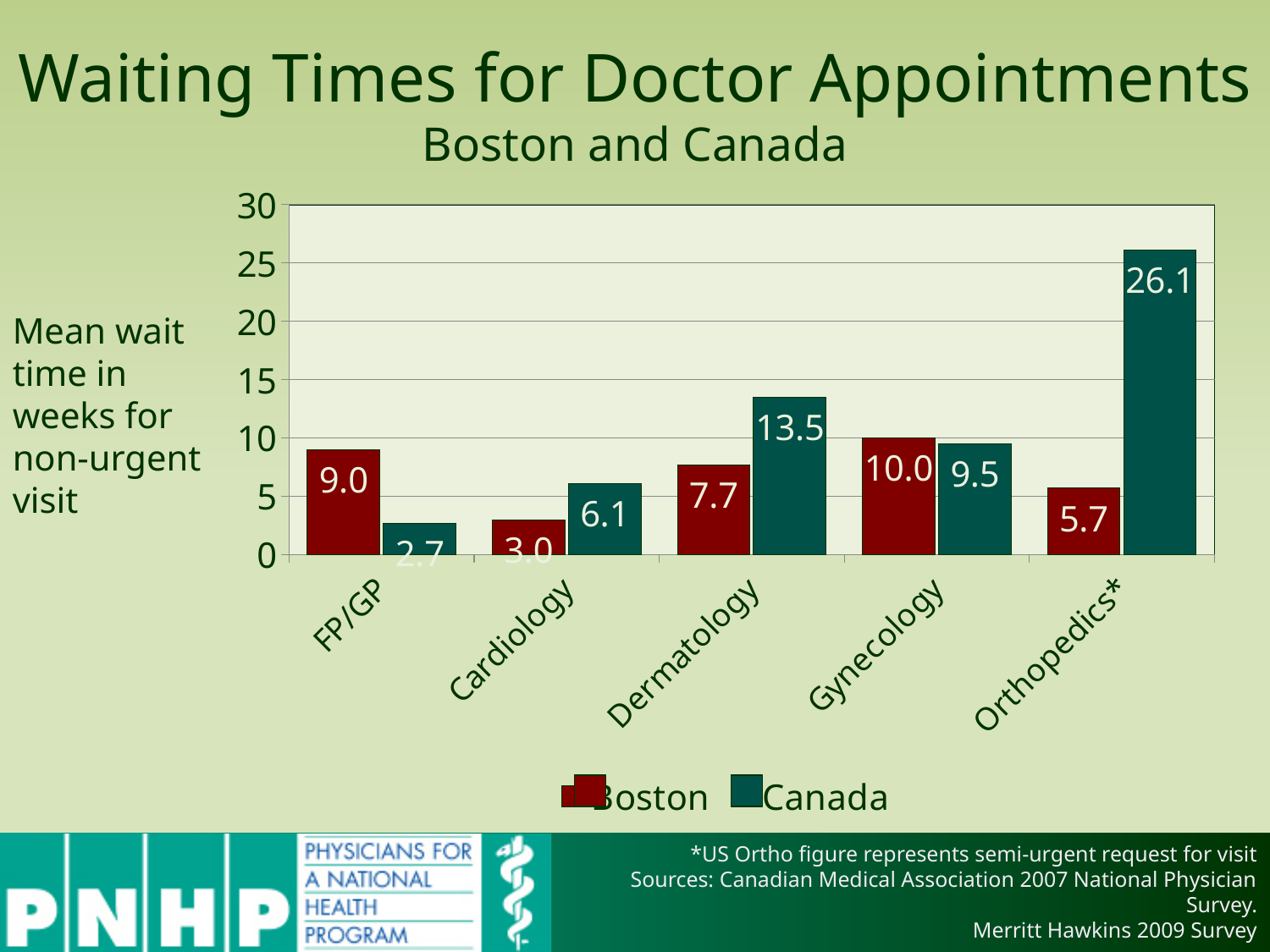
What is the difference in weeks between the Canada and Boston wait times for Orthopedics*? 20.4 Which specialty has the lowest Boston wait time? Cardiology How many specialties are shown on the x axis? 5 Which specialty has the highest Canada wait time? Orthopedics* What is the mean wait time in weeks for a Canada Orthopedics* appointment? 26.1 How many series does the legend list? 2 What is the mean wait time in weeks for a Boston FP/GP appointment? 9.0 Is the Canada wait time for Orthopedics* greater or less than 25? greater What kind of chart is shown on the slide? Bar chart What is the mean wait time in weeks for a Canada Dermatology appointment? 13.5 What is the mean wait time in weeks for a Boston Gynecology appointment? 10.0 Which is larger, the Boston or the Canada wait time for Dermatology? Canada